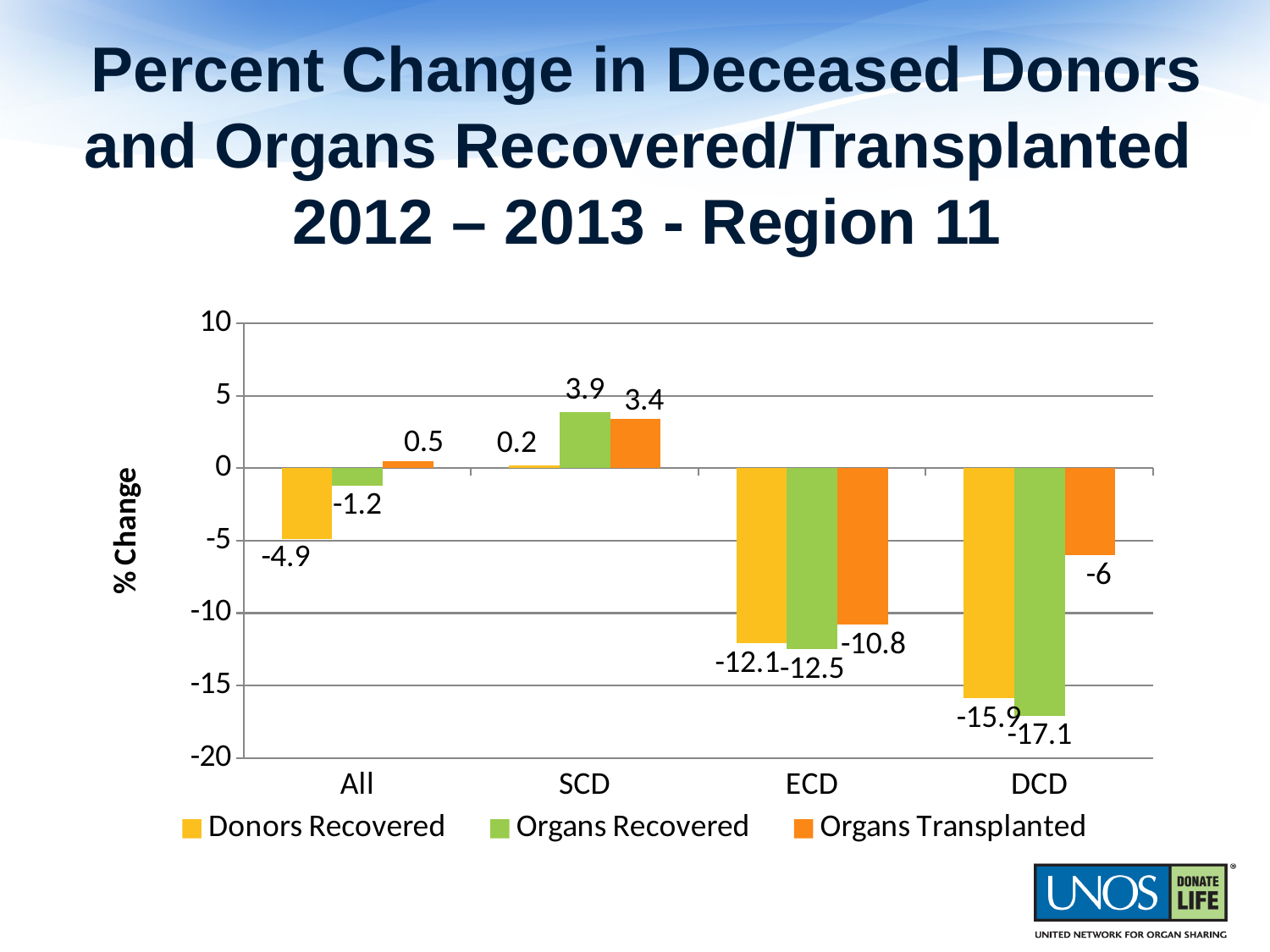
What is the Organs Recovered value for SCD? 3.9 What is the difference between the Donors Recovered values for DCD and ECD? 3.8 How many categories are shown on the x axis? 4 Which category has the highest Organs Transplanted value? SCD What is the Donors Recovered value for the All category? -4.9 Which is larger for DCD: the Donors Recovered value or the Organs Transplanted value? Organs Transplanted What is the Organs Recovered value for ECD? -12.5 What is the label of the y axis? % Change What kind of chart is shown on the slide? Bar chart How many series does the legend list? 3 Which category has the lowest Organs Recovered value? DCD What is the Organs Transplanted value for DCD? -6